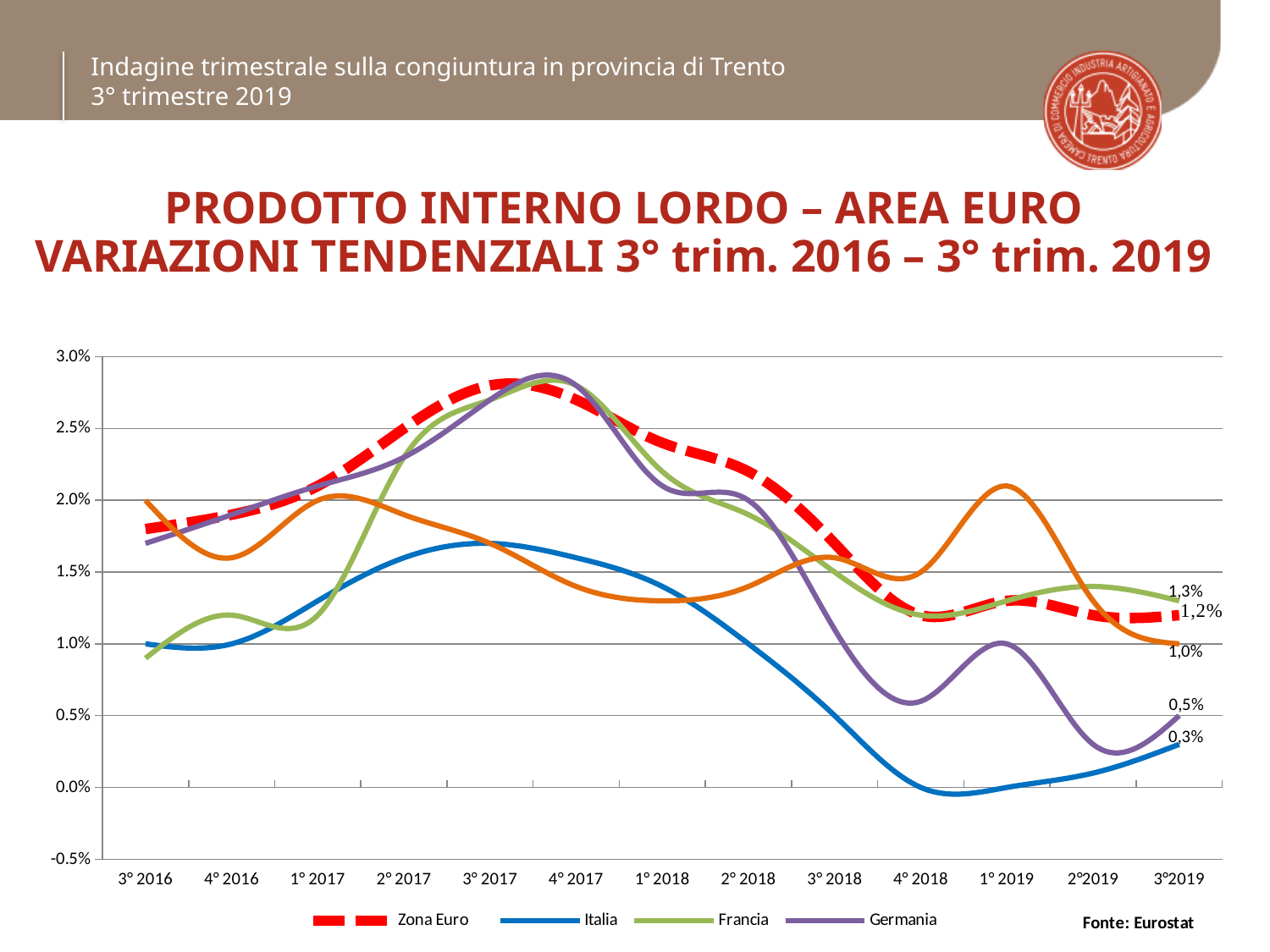
What kind of chart is shown on the slide? line chart How many series does the legend list? 4 Is the value for Germania in 4° 2017 greater or less than 2.5%? greater Which series has the lowest value in 3°2019? Italia What is the value for Zona Euro in 3°2019? 1,2% How many quarters are shown along the x axis? 13 Does the Italia line rise or fall from 3° 2017 to 4° 2018? fall What is the value for Francia in 3°2019? 1,3% Is the value for Italia in 4° 2018 greater or less than 0.5%? less What is the value for Italia in 3°2019? 0,3% What is the difference between the Francia and Italia values in 3°2019? 1,0% What is the value for Germania in 3°2019? 0,5%